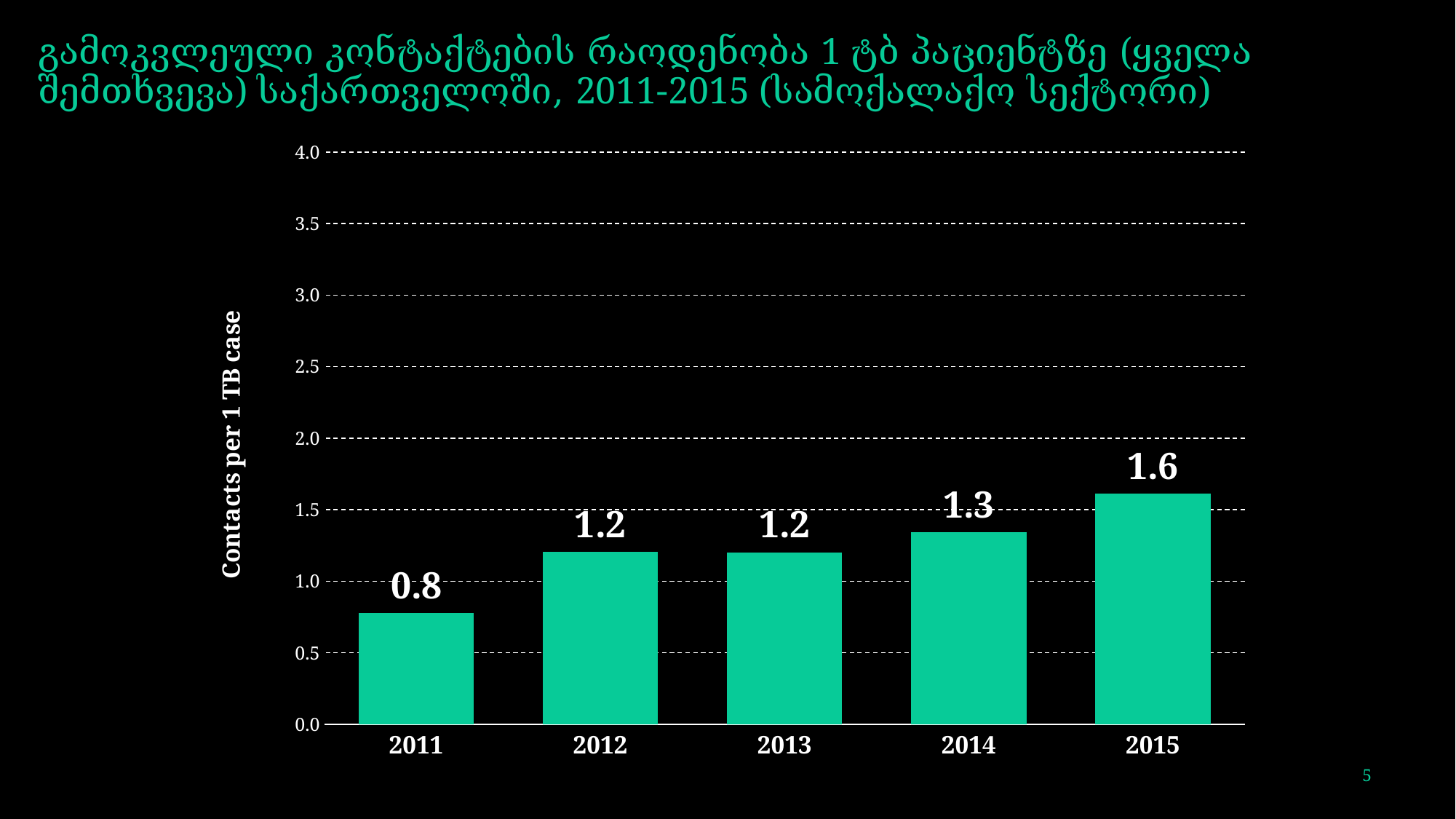
How many years are shown on the x axis? 5 What kind of chart is shown on the slide? bar chart Which year has the lowest number of contacts per 1 TB case? 2011 Do the values generally rise or fall from 2011 to 2015? rise What is the value for 2011? 0.8 Is the value for 2015 greater or less than 1.5? greater Which year has the highest number of contacts per 1 TB case? 2015 What is the difference between the values for 2015 and 2011? 0.8 What is the label of the vertical axis? Contacts per 1 TB case What is the value for 2014? 1.3 What is the value for 2015? 1.6 Which is larger, the value for 2014 or the value for 2012? 2014